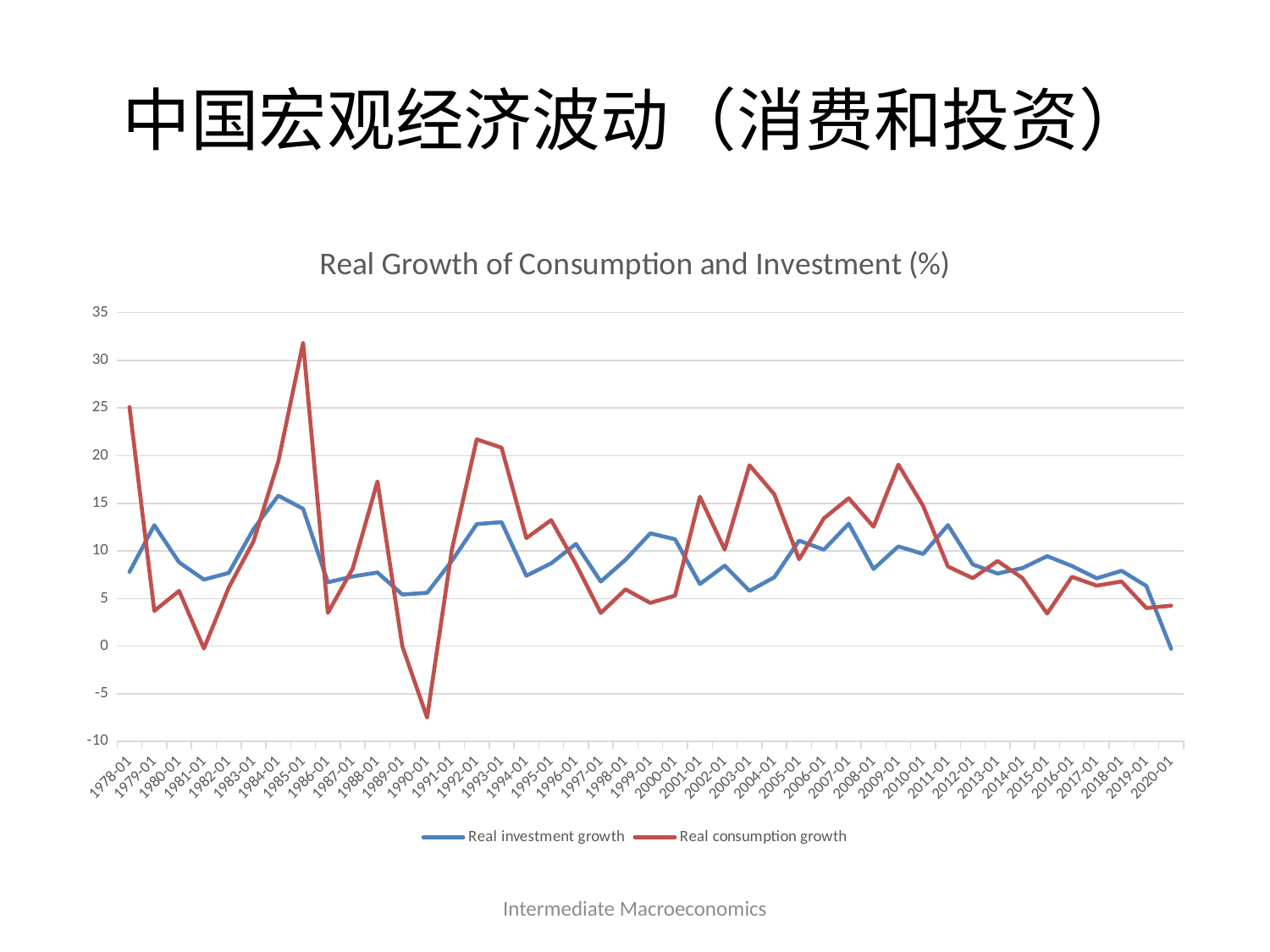
What kind of chart is shown on the slide? Line chart In which year does Real investment growth reach its lowest value? 2020-01 How many series does the legend list? 2 Is the value of Real consumption growth at 1990-01 greater or less than -5? less In which year does Real consumption growth reach its highest value? 1985-01 How many yearly points are plotted along the x axis, from 1978-01 to 2020-01? 43 Is the value of Real consumption growth at 1985-01 greater or less than 30? greater What is the title of the chart? Real Growth of Consumption and Investment (%) Which series is drawn in red? Real consumption growth Does Real consumption growth rise or fall from 2009-01 to 2012-01? Fall In which year does Real consumption growth reach its lowest value? 1990-01 At 1990-01, which series has the larger value, Real investment growth or Real consumption growth? Real investment growth